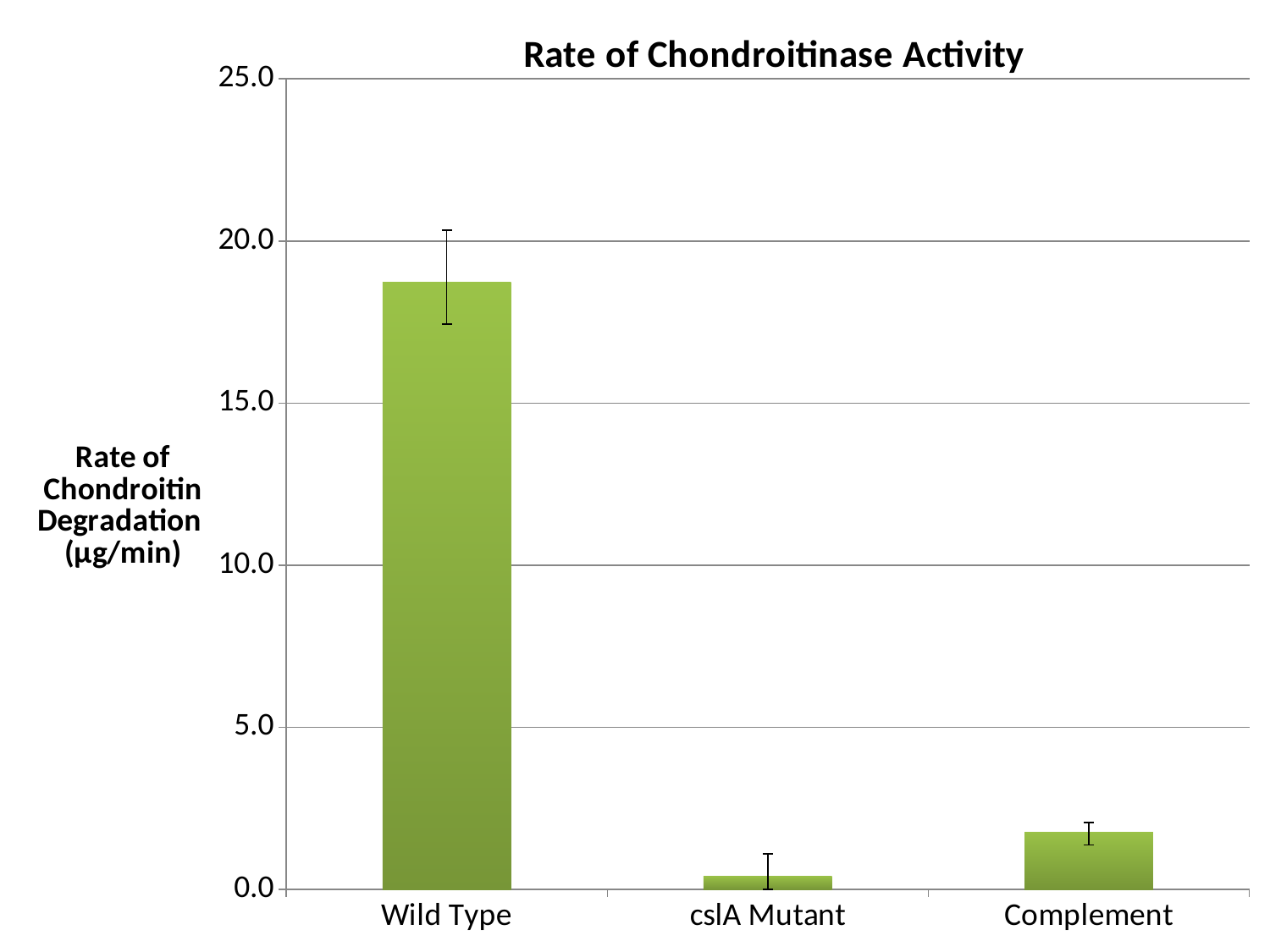
Which category has the lowest rate of chondroitin degradation? cslA Mutant Which category has the highest rate of chondroitin degradation? Wild Type Is the value for Wild Type greater or less than 15.0? greater Which is larger, the value for Wild Type or the value for Complement? Wild Type Is the value for Wild Type greater or less than 20.0? less Is the value for Complement greater or less than 5.0? less How many categories are plotted on the x axis? 3 What kind of chart is shown on the slide? bar chart What is the title of the chart? Rate of Chondroitinase Activity What is the label of the y axis? Rate of Chondroitin Degradation (µg/min) Which is larger, the value for Complement or the value for cslA Mutant? Complement